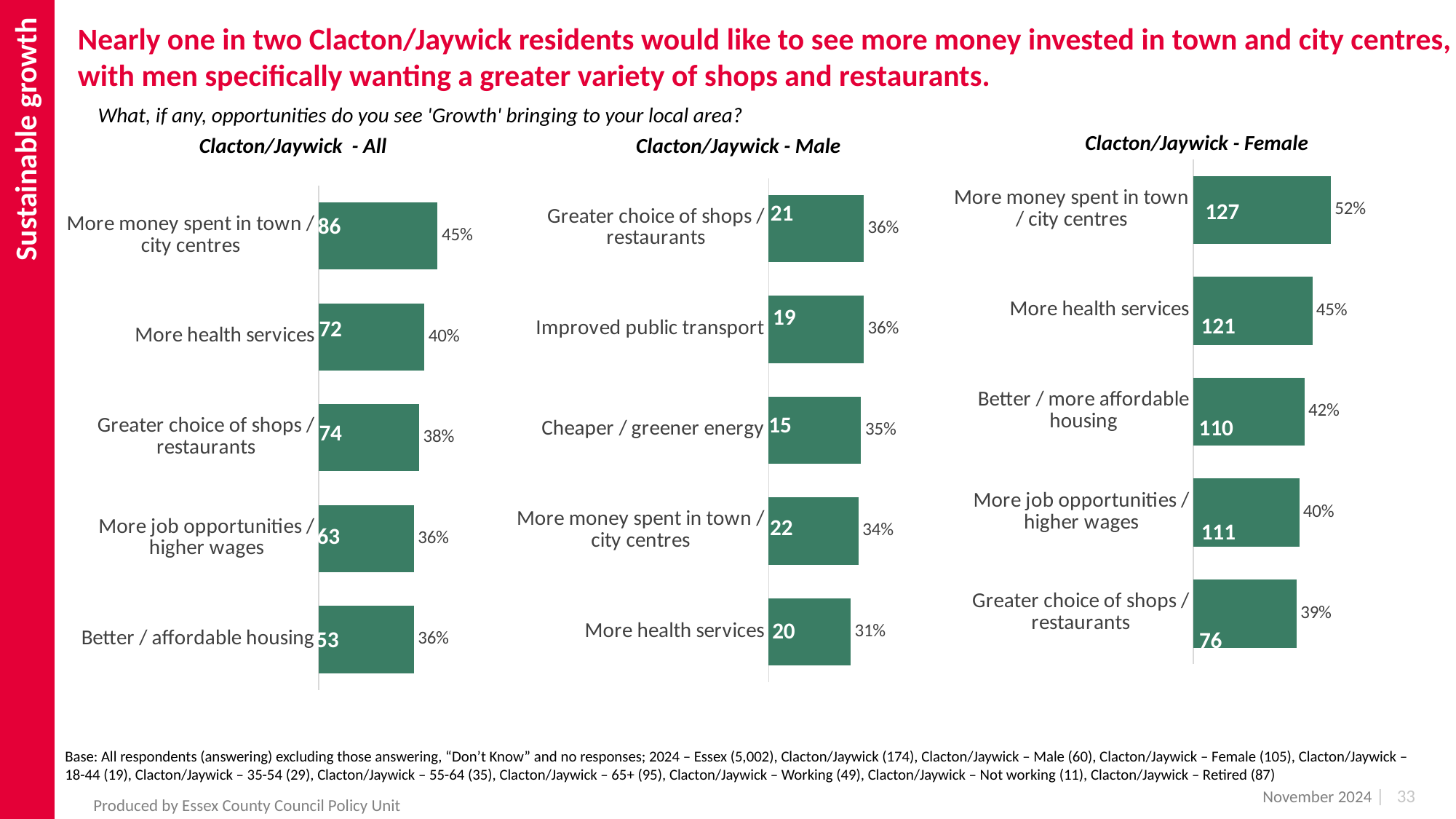
What is the title of the chart on the right of the slide? Clacton/Jaywick - Female In the Clacton/Jaywick - Male chart, what percentage is shown for 'More health services'? 31% In the Clacton/Jaywick - Female chart, what percentage is shown for 'Greater choice of shops / restaurants'? 39% What type of chart is the Clacton/Jaywick - All chart? Bar chart In the Clacton/Jaywick - Female chart, what percentage is shown for 'More money spent in town / city centres'? 52% In the Clacton/Jaywick - All chart, what percentage is shown for 'More money spent in town / city centres'? 45% In the Clacton/Jaywick - All chart, what percentage is shown for 'More health services'? 40% In the Clacton/Jaywick - Female chart, which has a higher percentage: 'More health services' or 'Better / more affordable housing'? More health services In the Clacton/Jaywick - All chart, what is the difference in percentage points between 'More money spent in town / city centres' and 'Better / affordable housing'? 9 How many categories are shown in the Clacton/Jaywick - Male chart? 5 In the Clacton/Jaywick - Male chart, which category has the lowest percentage? More health services In the Clacton/Jaywick - Female chart, which category has the highest percentage? More money spent in town / city centres